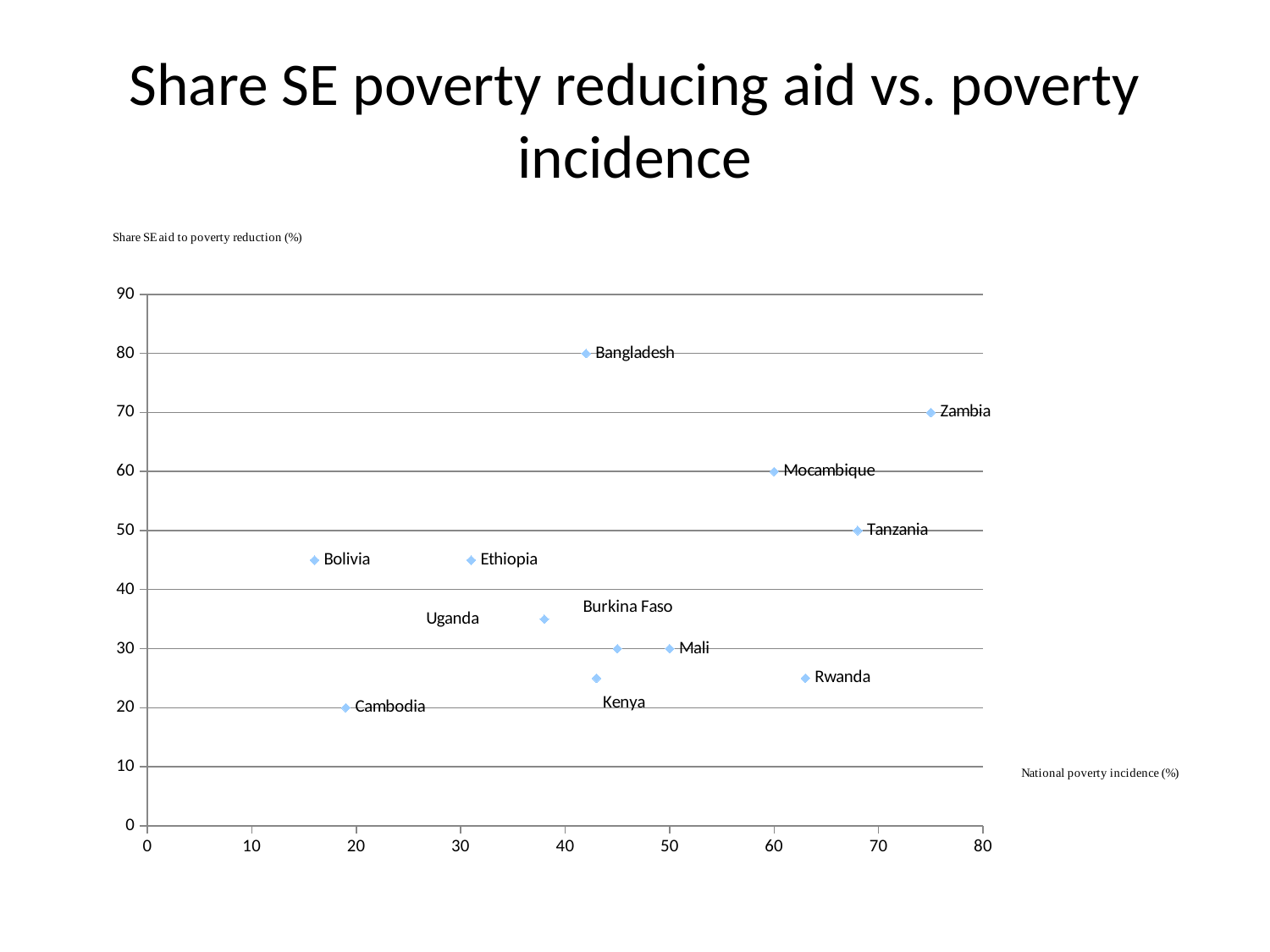
Which country has the highest share of SE aid to poverty reduction? Bangladesh How many countries are plotted on the chart? 12 What is the label of the horizontal axis? National poverty incidence (%) Which has a higher share of SE aid to poverty reduction, Tanzania or Mocambique? Mocambique Is the share of SE aid to poverty reduction for Bolivia greater or less than 40? greater Is the share of SE aid to poverty reduction for Rwanda greater or less than 30? less What kind of chart is shown on the slide? Scatter chart What is the share of SE aid to poverty reduction for Mocambique? 60 What is the share of SE aid to poverty reduction for Bangladesh? 80 Which country has the highest national poverty incidence? Zambia What is the difference in share of SE aid to poverty reduction between Bangladesh and Zambia? 10 Which country has the lowest share of SE aid to poverty reduction? Cambodia